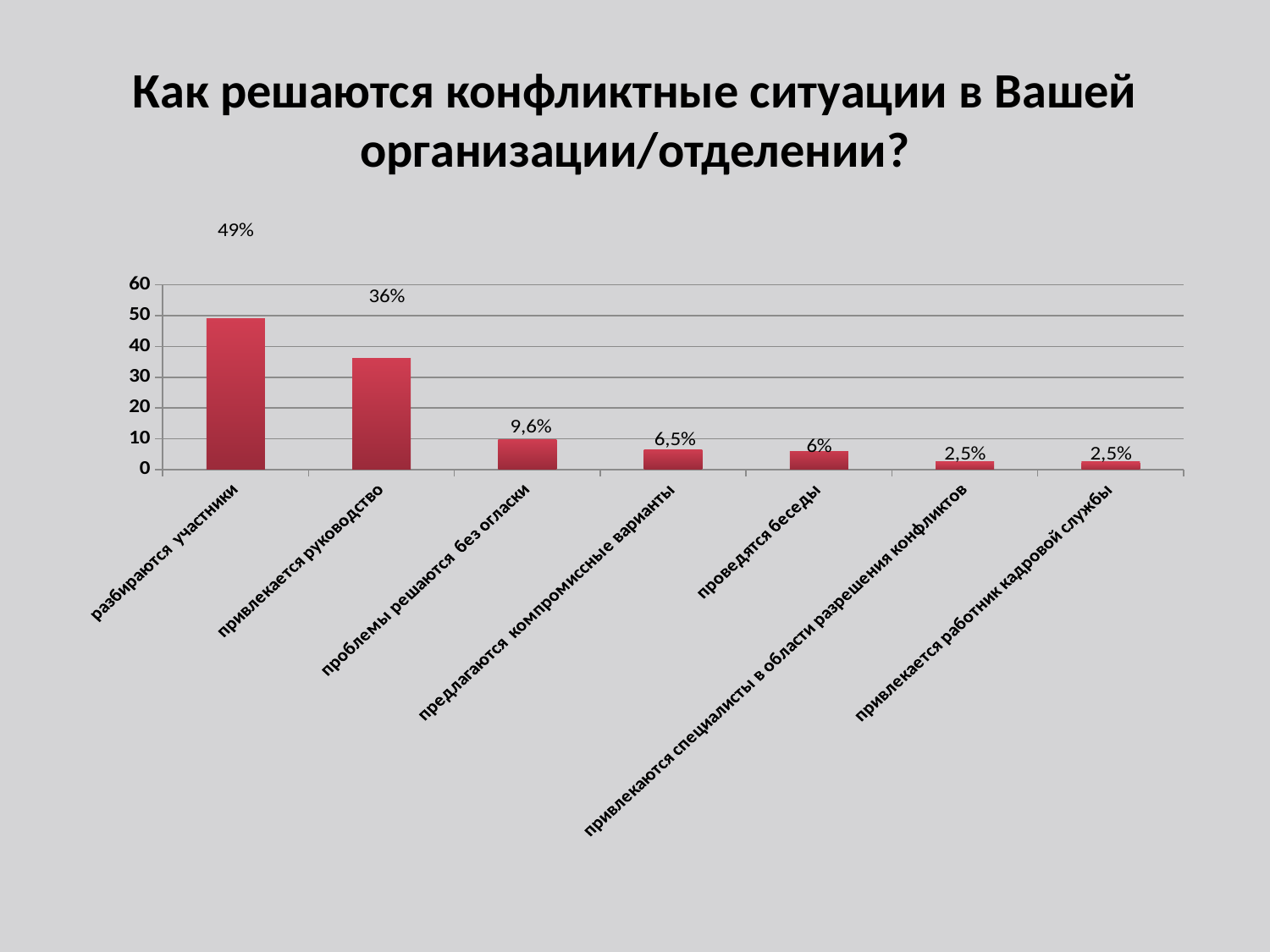
How many categories are shown in the chart? 7 What is the value for «привлекается руководство»? 36% What is the title of the slide? Как решаются конфликтные ситуации в Вашей организации/отделении? Which category has the highest value? разбираются участники What is the difference between the values for «разбираются участники» and «привлекается руководство»? 13% Do the values rise or fall from left to right along the x axis? fall What is the value for «привлекается работник кадровой службы»? 2,5% What is the value for «проблемы решаются без огласки»? 9,6% Which is larger: the value for «предлагаются компромиссные варианты» or the value for «проведятся беседы»? предлагаются компромиссные варианты What kind of chart is shown on the slide? bar chart Is the value for «привлекается руководство» greater or less than 30? greater What is the value for «разбираются участники»? 49%